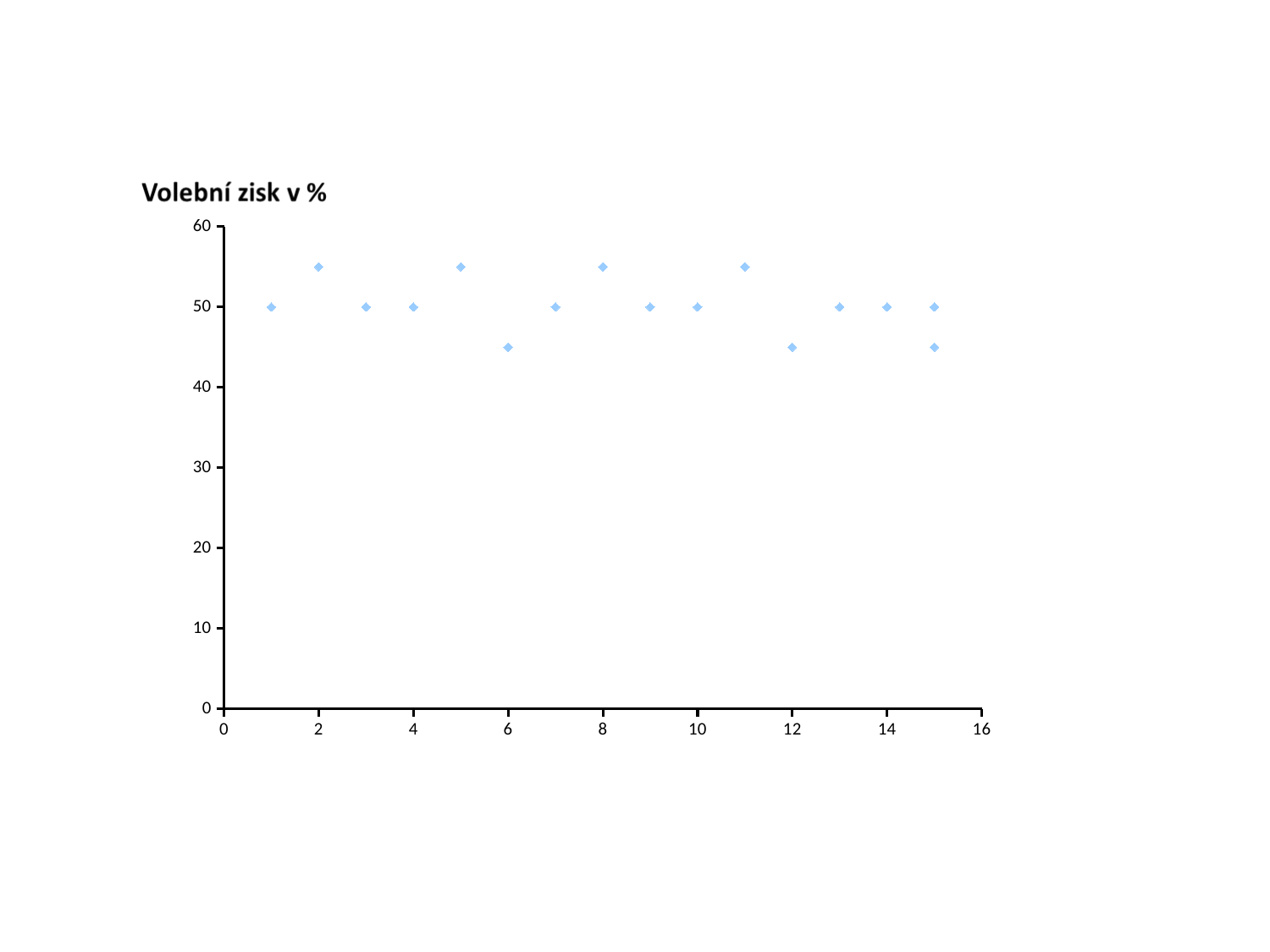
How many data points are plotted on the chart? 16 What kind of chart is shown on the slide? scatter chart What is the value of the point at x = 1? 50 Which has the larger value, the point at x = 2 or the point at x = 6? x = 2 Is the value of the point at x = 8 greater or less than 50? greater What is the value of the point at x = 10? 50 What is the title of the chart? Volební zisk v % Which has the larger value, the point at x = 12 or the point at x = 11? x = 11 Is the value of the point at x = 2 greater or less than 50? greater What is the value of the point at x = 3? 50 Is the value of the point at x = 6 greater or less than 50? less